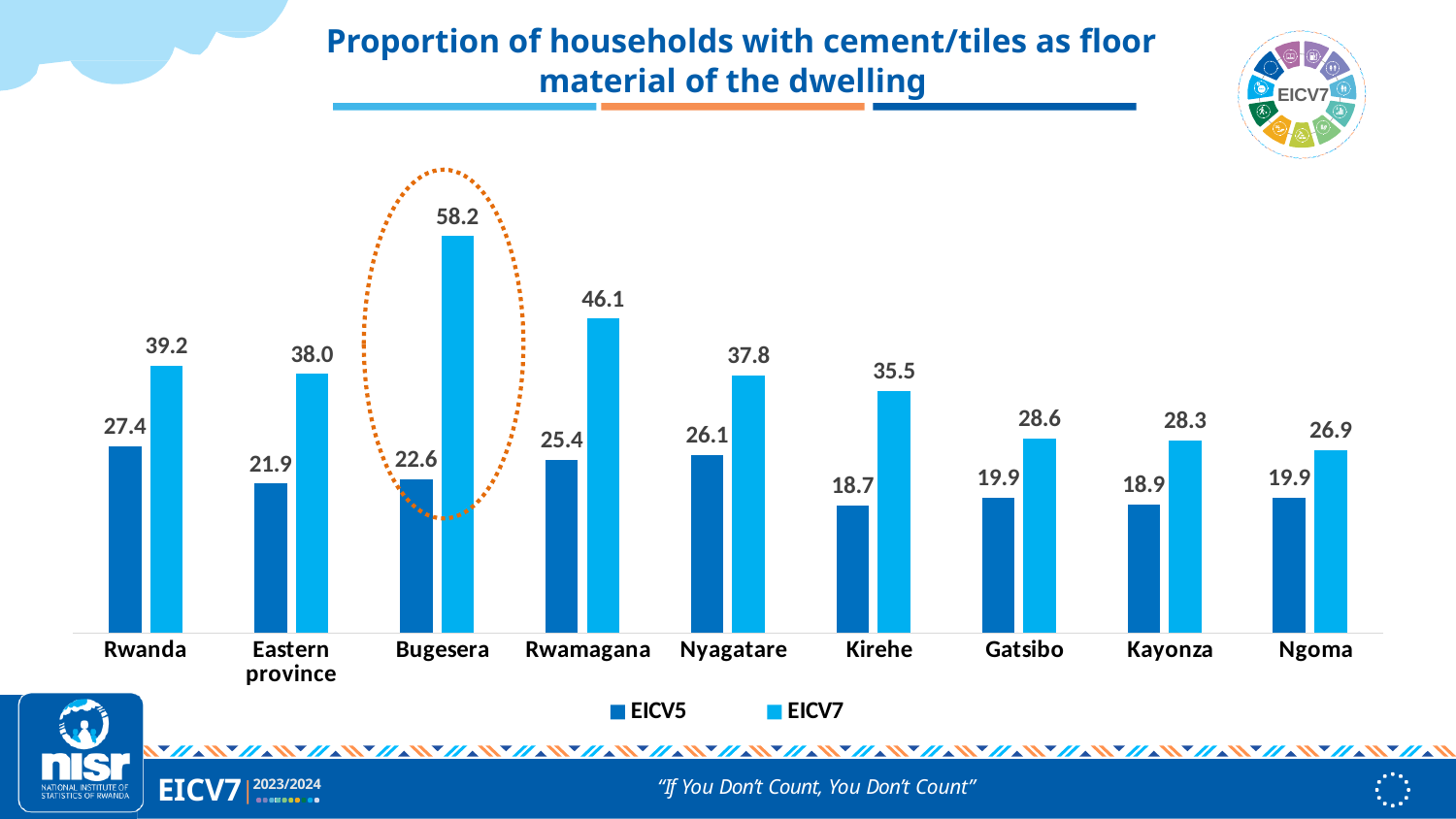
Which category has the lowest EICV5 value? Kirehe What is the difference between the EICV7 and EICV5 values for Bugesera? 35.6 What is the EICV5 value for Rwanda? 27.4 What kind of chart is shown on the slide? Bar chart What is the EICV7 value for Bugesera? 58.2 How many categories are shown on the x axis? 9 Which category has the highest EICV7 value? Bugesera Which category is highlighted with a dotted orange circle? Bugesera How many series does the legend list? 2 What is the EICV7 value for Kirehe? 35.5 Which is larger, the EICV7 value for Rwamagana or the EICV7 value for Nyagatare? Rwamagana What is the difference between the EICV7 values for Eastern province and Ngoma? 11.1